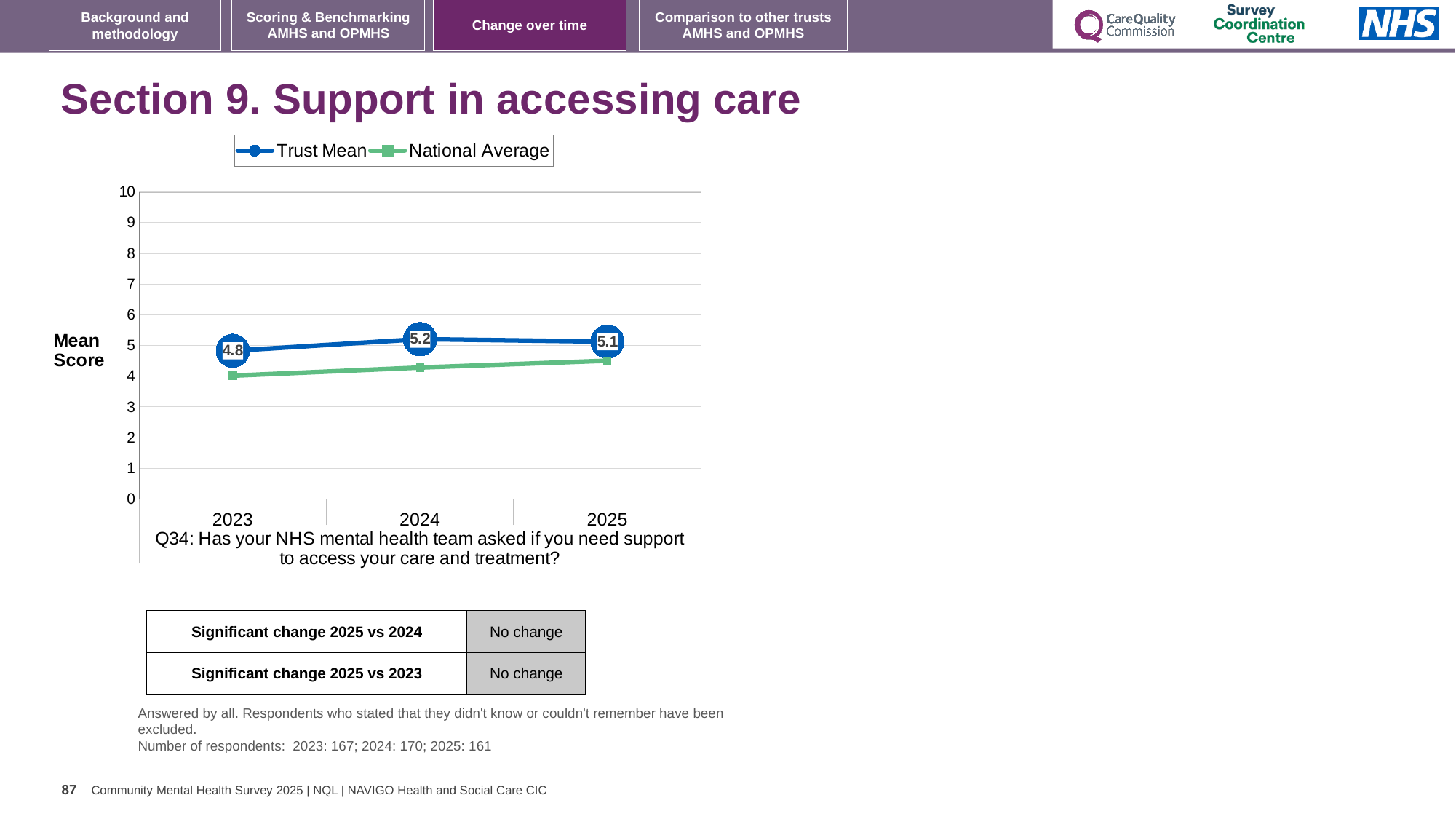
What is the difference between the Trust Mean in 2024 and in 2023? 0.4 What kind of chart is shown on the slide? Line chart In which year is the Trust Mean lowest? 2023 In which year is the Trust Mean highest? 2024 In 2023, which is larger: the Trust Mean or the National Average? Trust Mean What is the Trust Mean score for 2025? 5.1 How many series does the legend list? 2 Is the National Average value for 2023 greater or less than 5? less What is the Trust Mean score for 2024? 5.2 How many years are plotted on the x axis? 3 What is the Trust Mean score for 2023? 4.8 Does the National Average rise or fall from 2023 to 2025? Rise